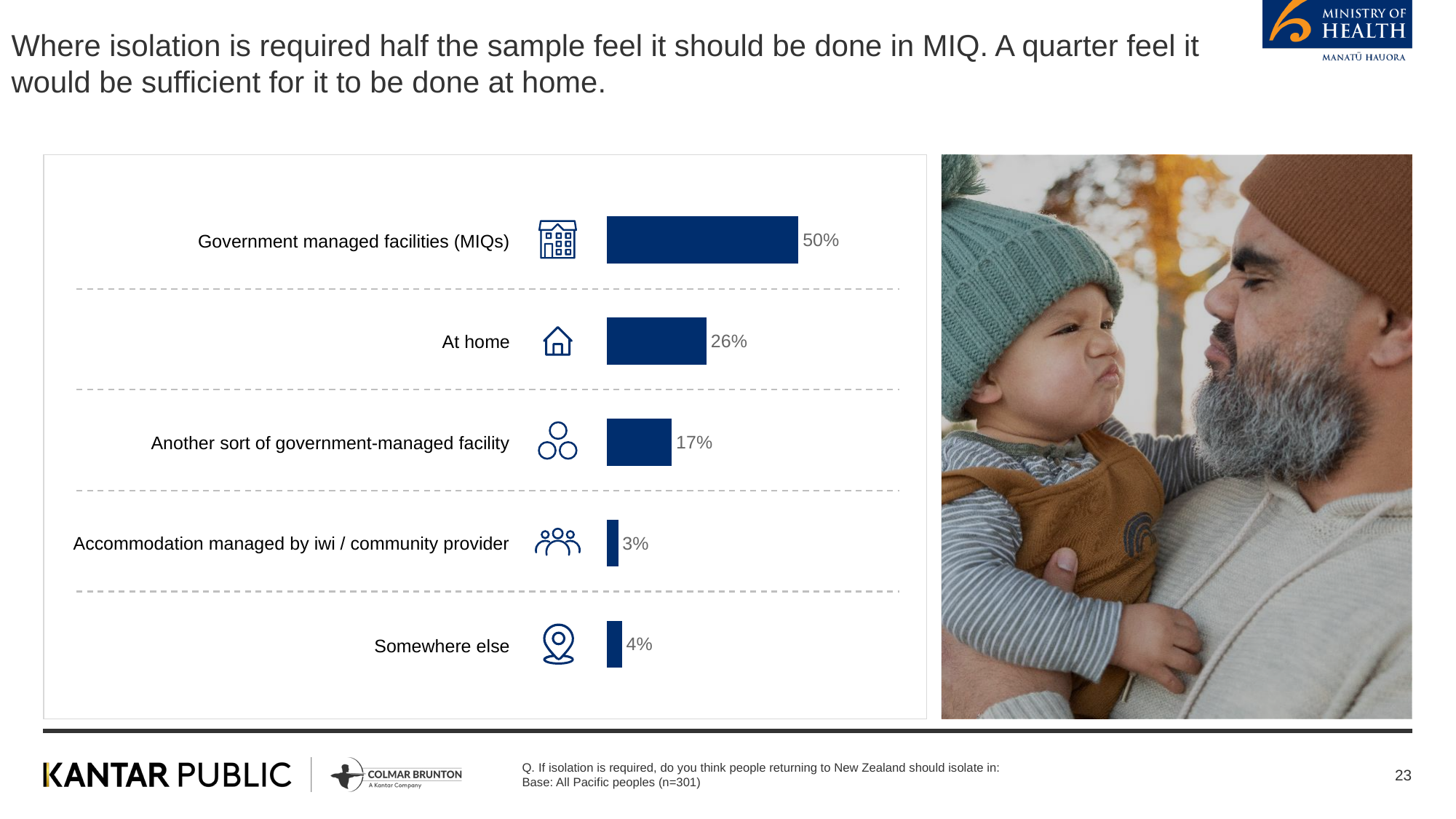
What is the value for Accommodation managed by iwi / community provider? 3% Which category has the highest value? Government managed facilities (MIQs) What kind of chart is shown on the slide? Bar chart What is the value for At home? 26% How many categories are shown in the chart? 5 What percentage chose Another sort of government-managed facility? 17% Which is larger, the value for At home or the value for Another sort of government-managed facility? At home What is the base sample size stated below the chart? All Pacific peoples (n=301) Which category has the lowest value? Accommodation managed by iwi / community provider What is the difference between the values for Government managed facilities (MIQs) and At home? 24 percentage points What percentage chose Somewhere else? 4% What percentage of respondents chose Government managed facilities (MIQs)? 50%